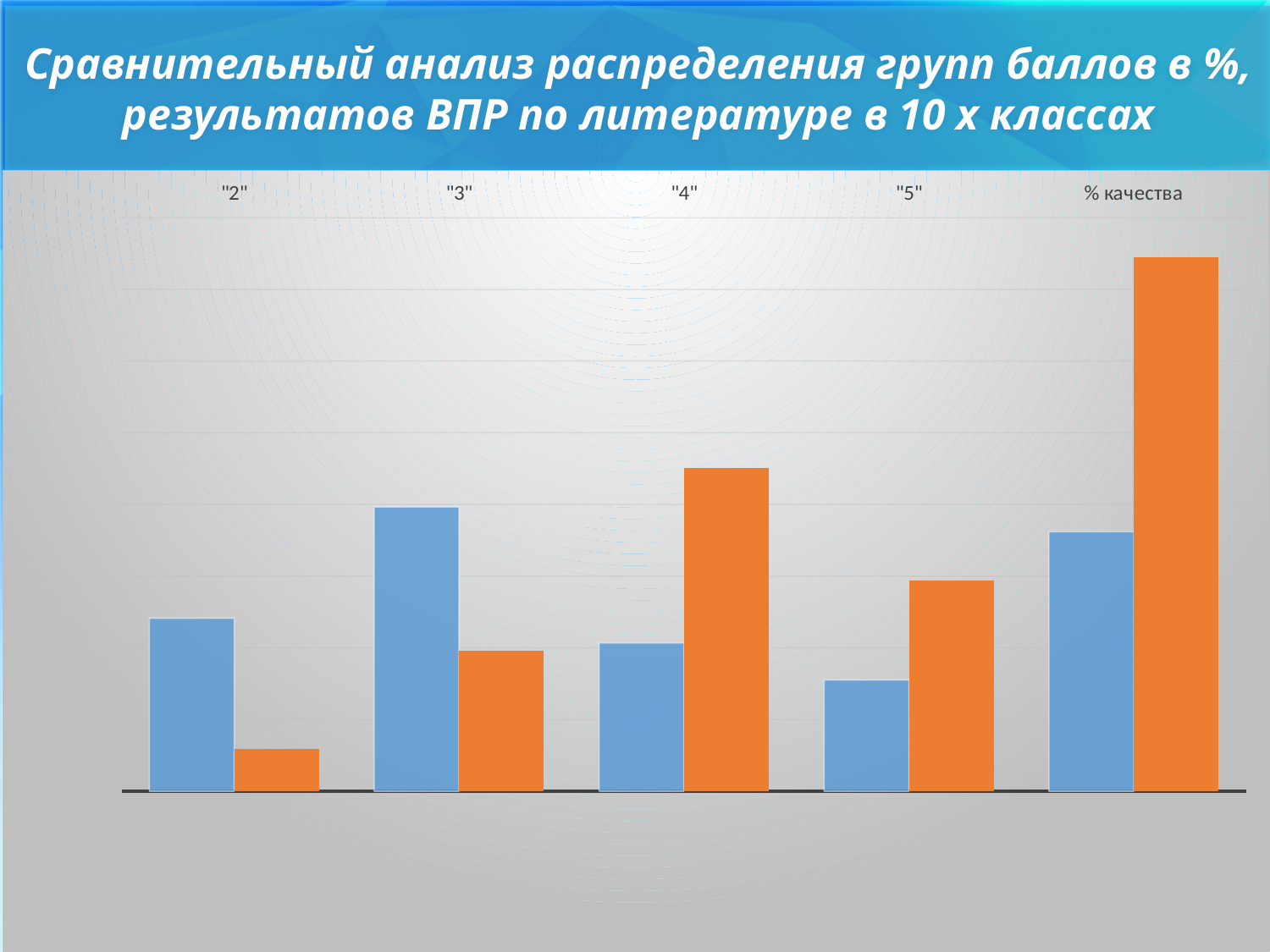
How many bars are plotted for each category in the chart? 2 Which category has the shortest blue bar? "5" For the category "3", which bar is taller, the blue one or the orange one? blue How many categories are shown along the x axis of the chart? 5 For the category "% качества", which bar is taller, the blue one or the orange one? orange Which category has the shortest orange bar? "2" Which category has the tallest orange bar? % качества For the category "2", which bar is taller, the blue one or the orange one? blue What is the label of the last category on the x axis of the chart? % качества What kind of chart is shown on the slide? bar chart Which category has the tallest blue bar? "3"